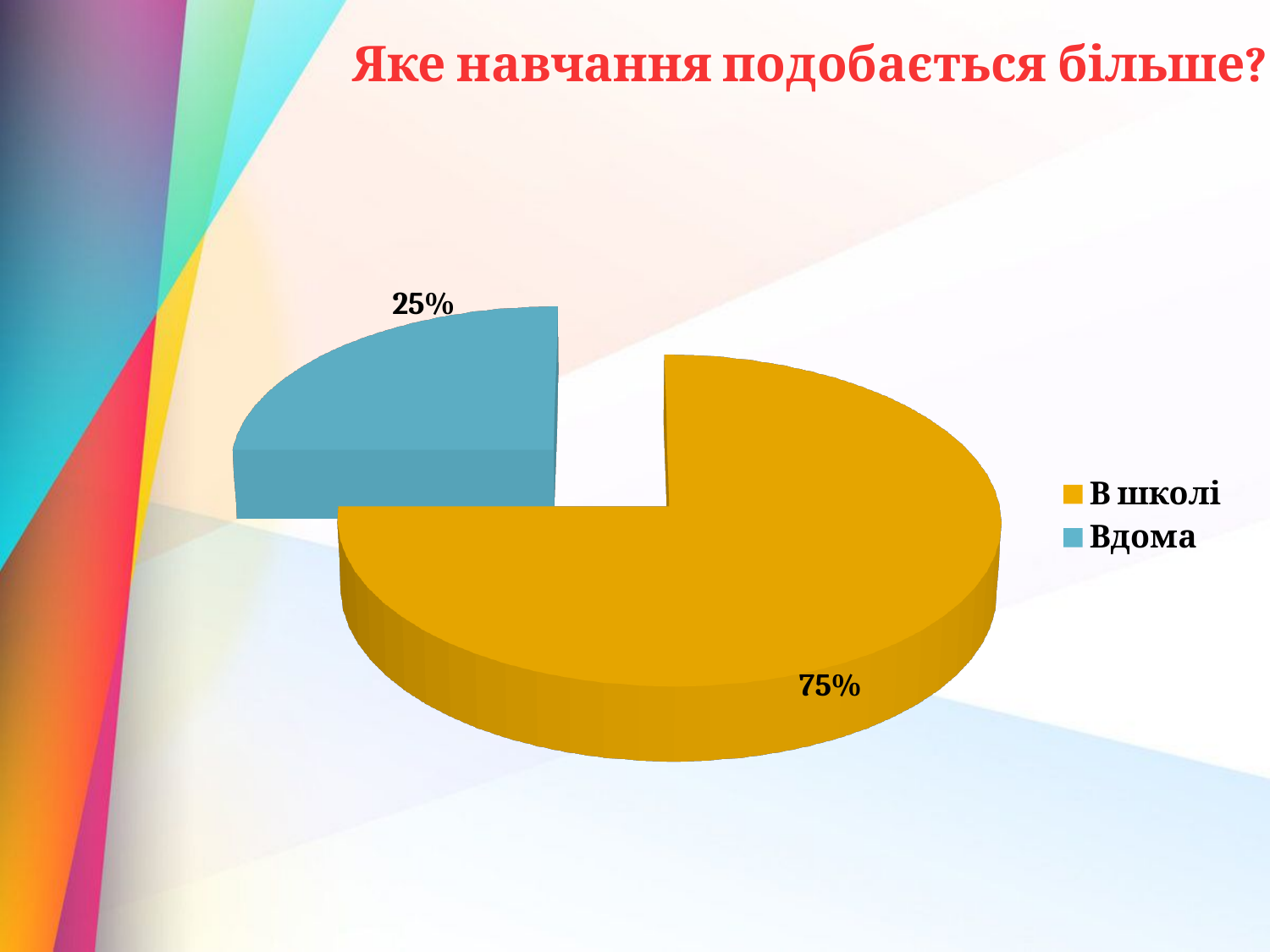
Which category has the largest slice of the pie? В школі What is the difference in percentage points between "В школі" and "Вдома"? 50 What share of the pie does "В школі" have? 75% What colour is the slice for "Вдома"? Blue What is the title of the slide above the chart? Яке навчання подобається більше? Which is larger, the slice for "В школі" or the slice for "Вдома"? В школі What share of the pie does "Вдома" have? 25% Which category has the smallest slice of the pie? Вдома What kind of chart is shown on the slide? Pie chart What is the total of the two slices shown? 100% How many slices does the pie chart have? 2